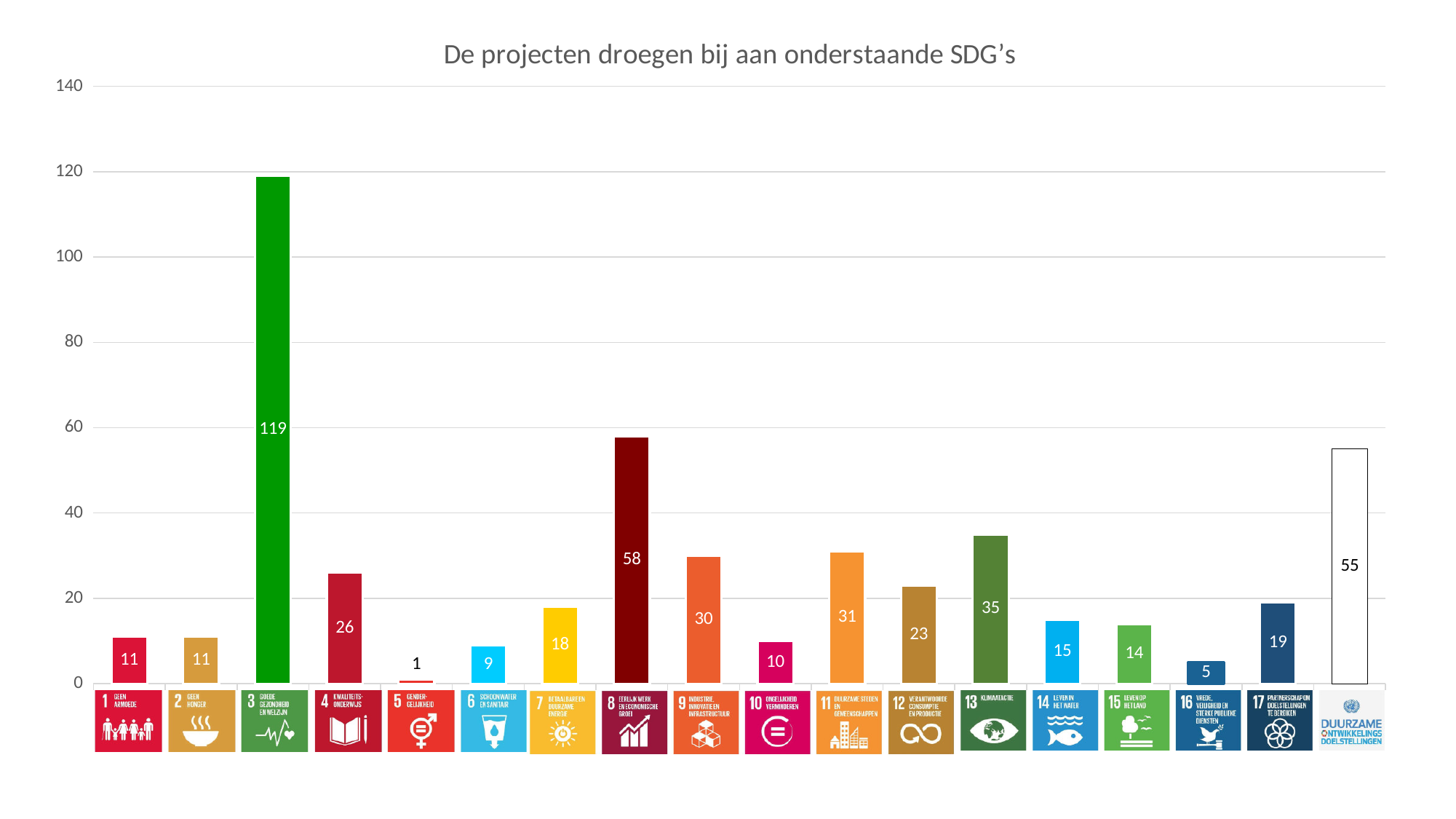
What is the value for SDG 3 (Goede gezondheid en welzijn)? 119 Which is larger, the value for SDG 11 or the value for SDG 9? SDG 11 What is the value for SDG 13 (Klimaatactie)? 35 What is the difference between the values for SDG 3 and SDG 8? 61 What is the value for SDG 8 (Eerlijk werk en economische groei)? 58 Which SDG has the highest value? SDG 3 (Goede gezondheid en welzijn) Which SDG has the lowest value? SDG 5 (Gendergelijkheid) What kind of chart is shown on the slide? Bar chart What is the value of the last, white bar (Duurzame ontwikkelingsdoelstellingen)? 55 Is the value for SDG 8 greater or less than 40? greater How many bars are plotted in the chart? 18 What is the title of the chart? De projecten droegen bij aan onderstaande SDG’s